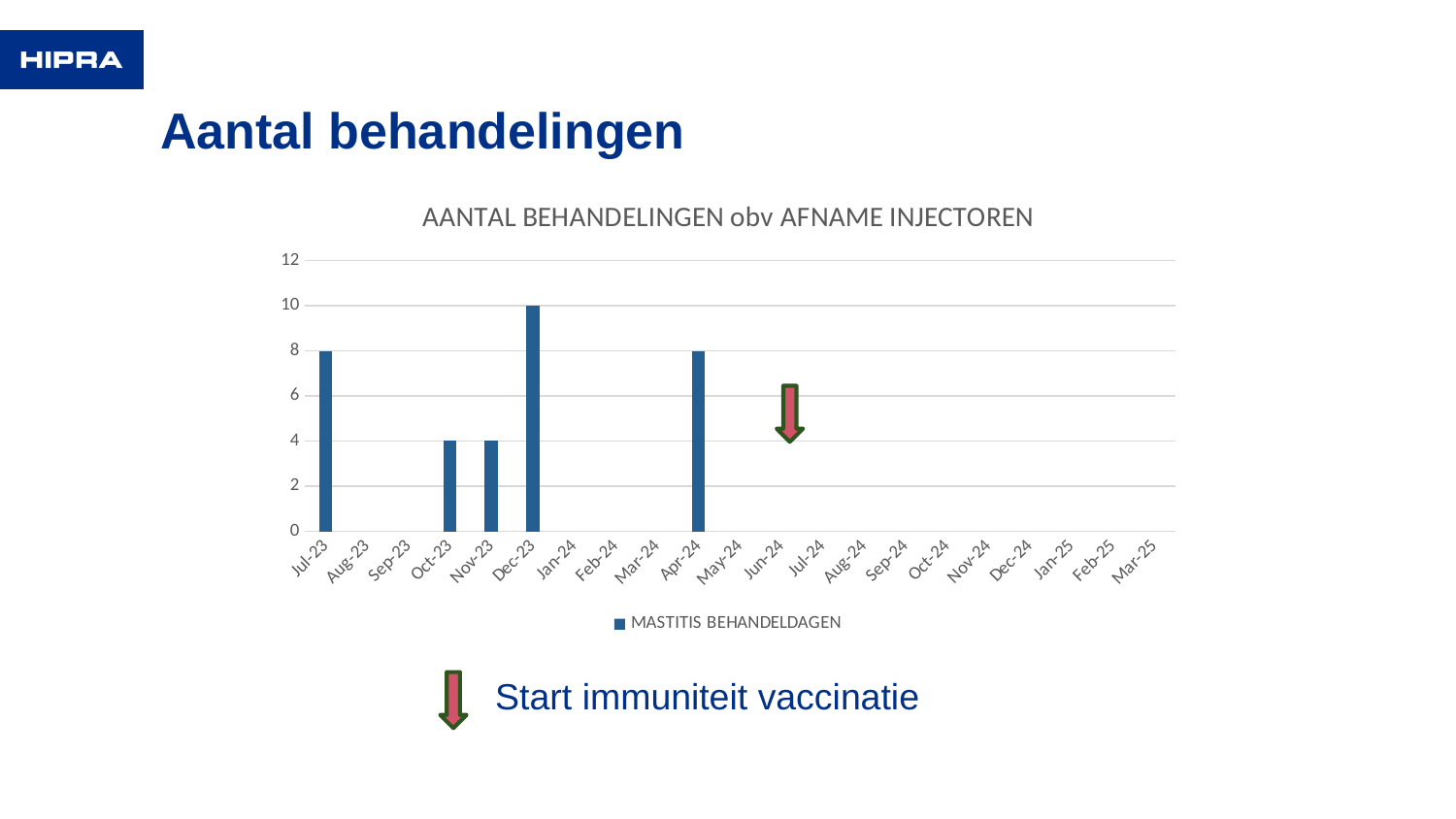
What is the title of the chart? AANTAL BEHANDELINGEN obv AFNAME INJECTOREN What is the value for Dec-23? 10 What is the value for Apr-24? 8 What kind of chart is shown on the slide? Bar chart Which is larger, the value for Jul-23 or the value for Oct-23? Jul-23 How many months are shown on the x axis? 21 How many series does the legend list? 1 What is the value for Jul-23? 8 What is the name of the series in the legend? MASTITIS BEHANDELDAGEN What is the value for Oct-23? 4 Which month has the highest value? Dec-23 What is the difference between the values for Dec-23 and Nov-23? 6